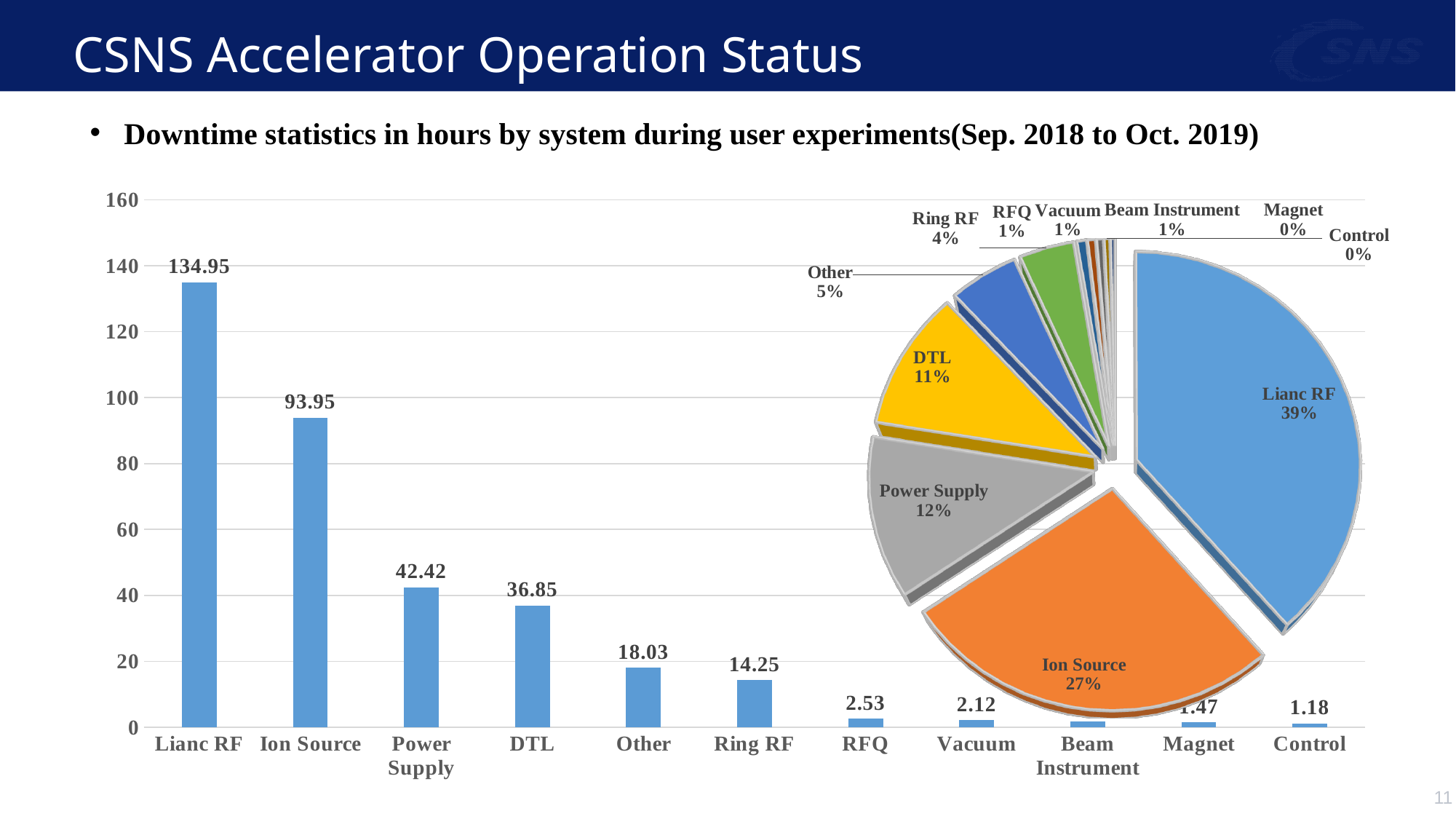
In the pie chart, what share does DTL have? 11% In the pie chart, what share does Ion Source have? 27% In the bar chart, what is the downtime value for Ring RF? 14.25 In the bar chart, what is the downtime value for Power Supply? 42.42 In the bar chart, which is larger, the value for Other or the value for Ring RF? Other In the bar chart, what is the difference between the Ion Source and DTL values? 57.1 In the bar chart, which category has the highest downtime? Lianc RF In the bar chart, how many categories are shown on the x axis? 11 In the bar chart, which category has the lowest downtime? Control In the pie chart, which slice is the largest? Lianc RF In the bar chart, what is the downtime value for Lianc RF? 134.95 What kind of chart is the chart on the left of the slide? Bar chart